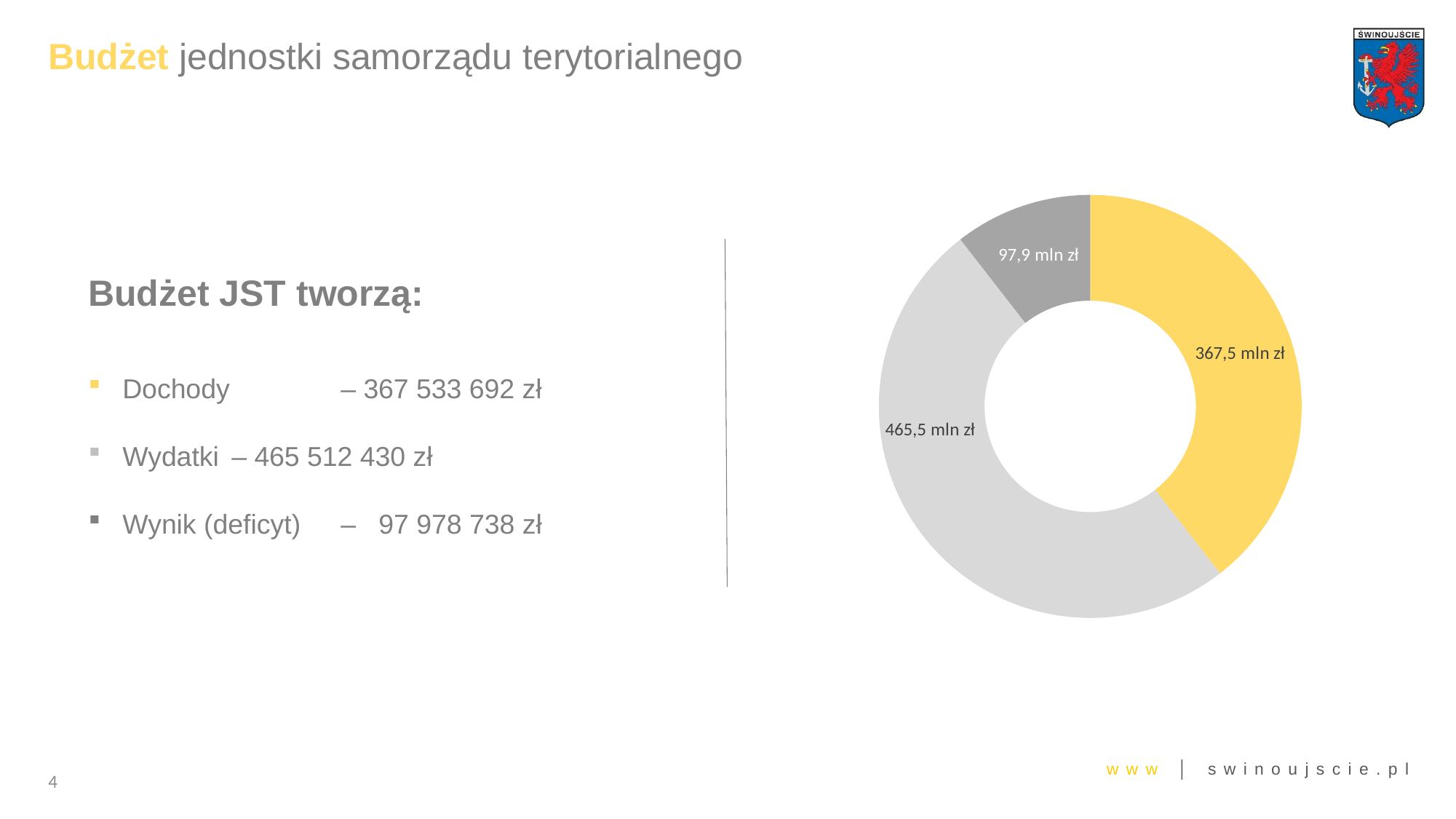
How many slices does the doughnut chart have? 3 Which is larger in the doughnut chart: the yellow slice or the light grey slice? the light grey slice (465,5 mln zł) What is the total of the three values labelled on the doughnut chart? 930,9 mln zł What colour is the slice representing Dochody in the doughnut chart? yellow Which budget category has the largest slice in the doughnut chart? Wydatki What type of chart is shown on the slide? doughnut (pie) chart What value is labelled on the dark grey slice of the doughnut chart? 97,9 mln zł What value is labelled on the light grey slice of the doughnut chart? 465,5 mln zł What is the difference between the yellow slice (367,5 mln zł) and the dark grey slice (97,9 mln zł)? 269,6 mln zł Which budget category has the smallest slice in the doughnut chart? Wynik (deficyt) What is the difference between the light grey slice (465,5 mln zł) and the yellow slice (367,5 mln zł)? 98,0 mln zł What value is labelled on the yellow slice of the doughnut chart? 367,5 mln zł